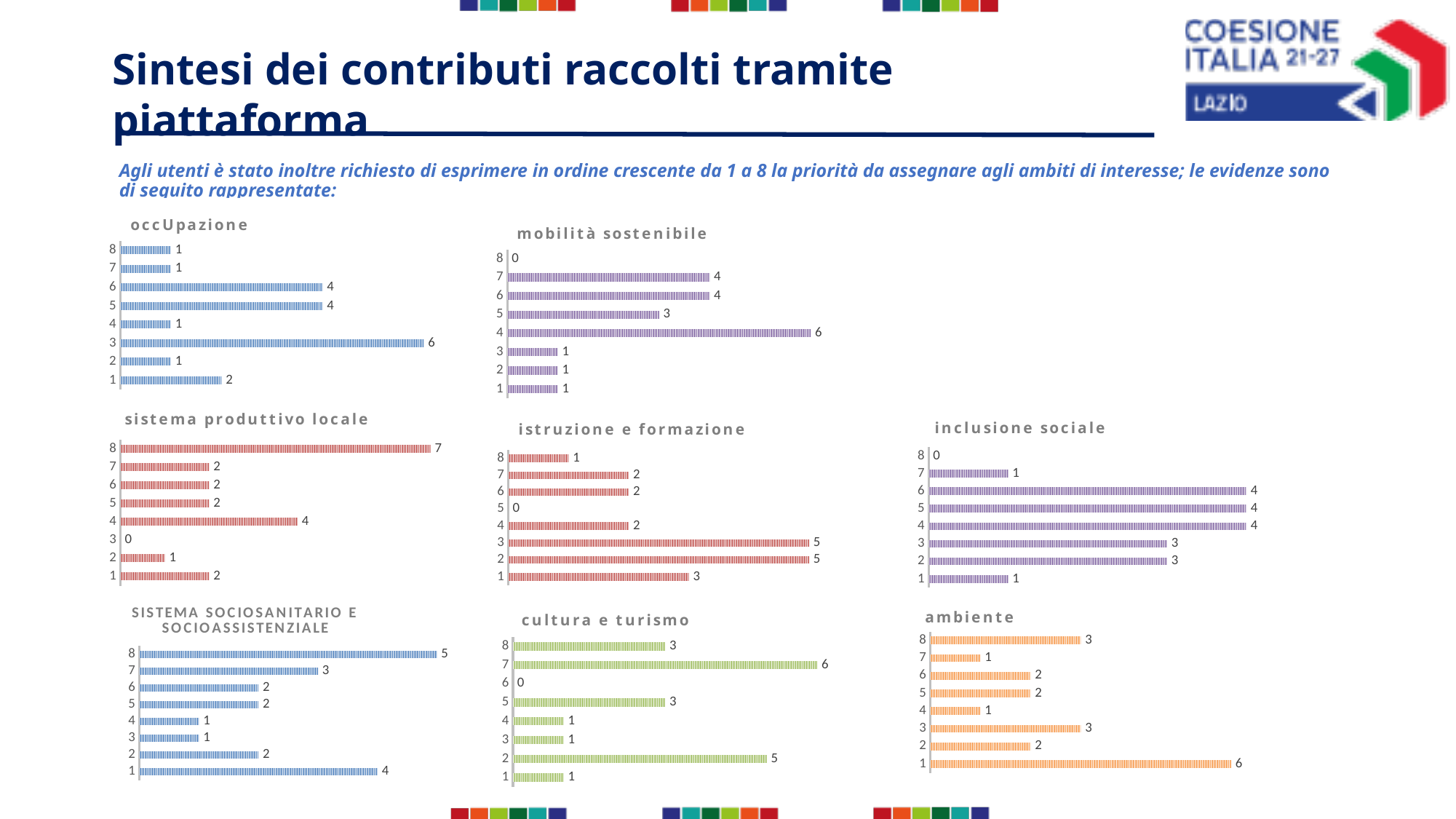
What type of chart is the 'occUpazione' chart? bar chart How many charts are shown on the slide? 8 In the 'istruzione e formazione' chart, what is the difference between the values for priority 3 and priority 1? 2 How many priority categories are shown in the 'ambiente' chart? 8 In the 'inclusione sociale' chart, what is the value for priority 8? 0 In the 'sistema produttivo locale' chart, which priority level has the lowest value? 3 In the 'cultura e turismo' chart, which priority level has the highest value? 7 In the 'ambiente' chart, what is the value for priority 1? 6 In the 'mobilità sostenibile' chart, which priority level has the highest value? 4 In the 'SISTEMA SOCIOSANITARIO E SOCIOASSISTENZIALE' chart, which is larger, the value for priority 8 or the value for priority 1? priority 8 In the 'occUpazione' chart, what is the value for priority 3? 6 In the 'sistema produttivo locale' chart, what is the value for priority 8? 7